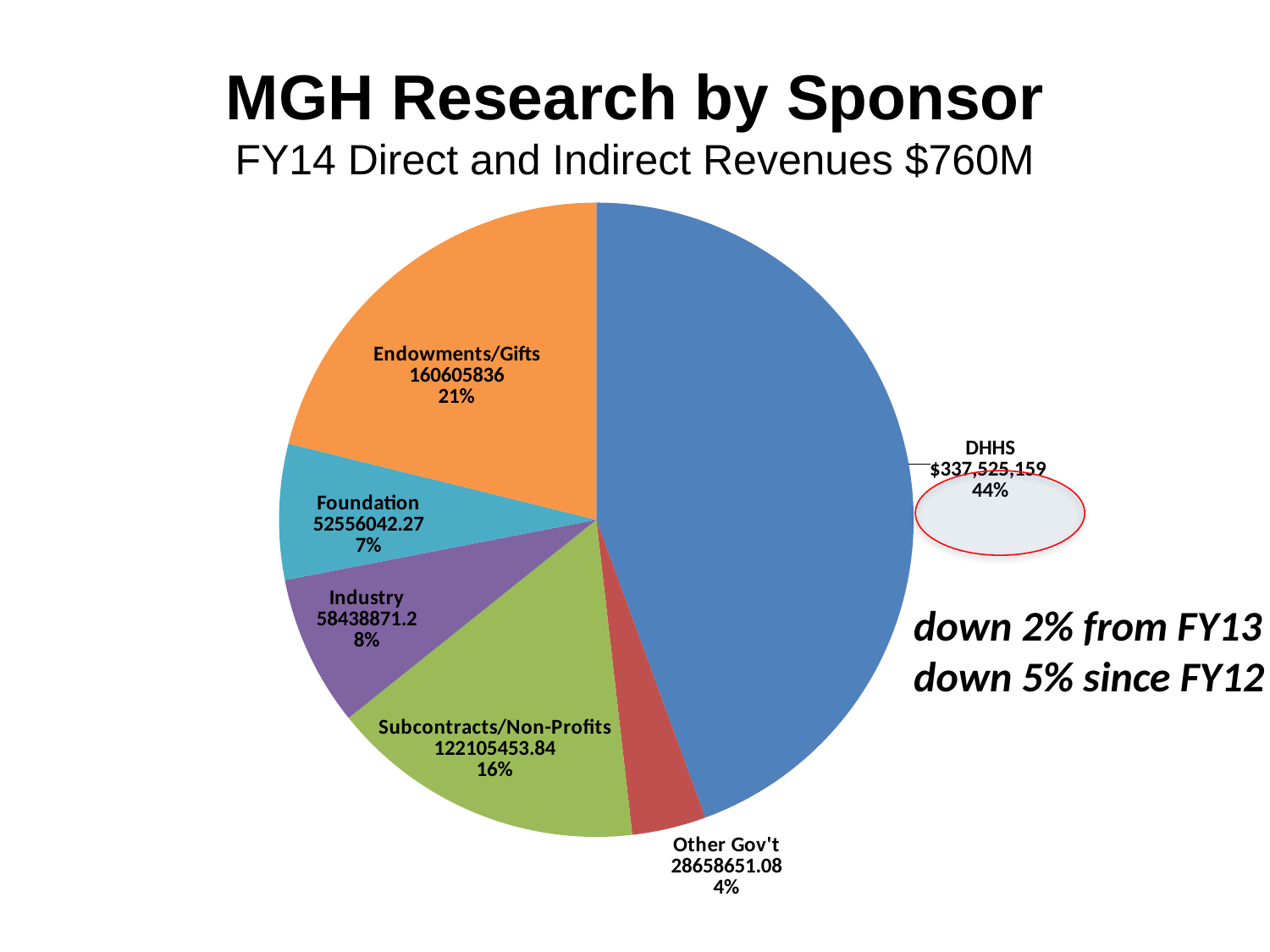
What is the difference in percentage share between Endowments/Gifts and Subcontracts/Non-Profits? 5% What percentage share of the pie does DHHS represent? 44% What kind of chart is shown on the slide? pie chart How many sponsor categories are shown in the pie chart? 6 What is the value shown for Other Gov't? 28658651.08 Which is larger, the share for Industry or the share for Foundation? Industry Which sponsor category has the smallest slice of the pie? Other Gov't What is the value shown for Subcontracts/Non-Profits? 122105453.84 What percentage share does Subcontracts/Non-Profits represent? 16% Which sponsor category has the largest slice of the pie? DHHS What is the title of the chart on the slide? MGH Research by Sponsor What is the value shown for Endowments/Gifts? 160605836